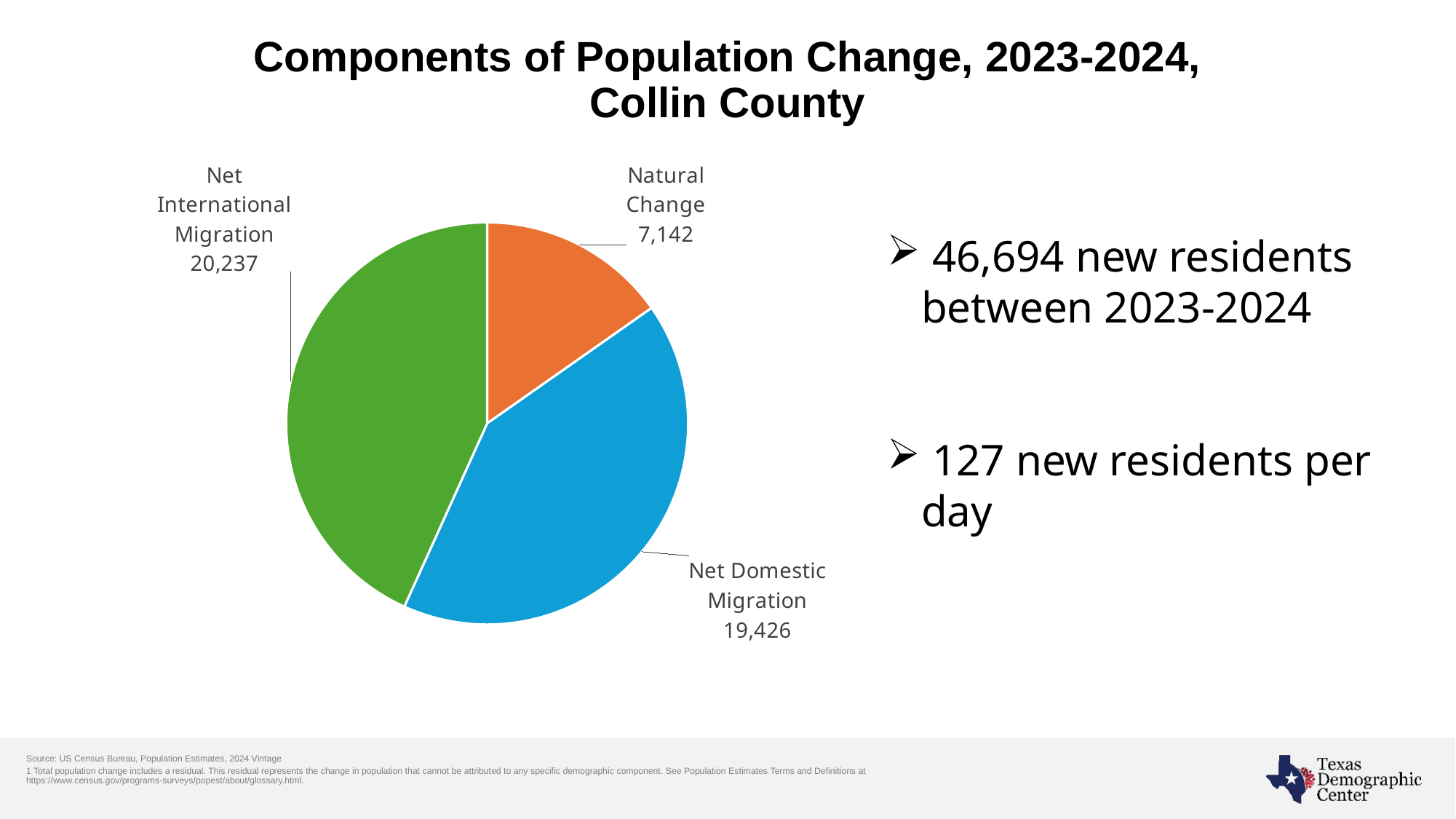
Which component has the largest value? Net International Migration What is the value for Net International Migration? 20,237 Which component has the smallest value? Natural Change What is the value for Natural Change? 7,142 What is the value for Net Domestic Migration? 19,426 How many slices does the pie chart have? 3 What is the difference between Net International Migration and Net Domestic Migration? 811 What colour is the Net International Migration slice? Green What is the difference between Net Domestic Migration and Natural Change? 12,284 What is the title of the chart? Components of Population Change, 2023-2024, Collin County Which is larger, Net Domestic Migration or Natural Change? Net Domestic Migration What type of chart is shown on the slide? Pie chart